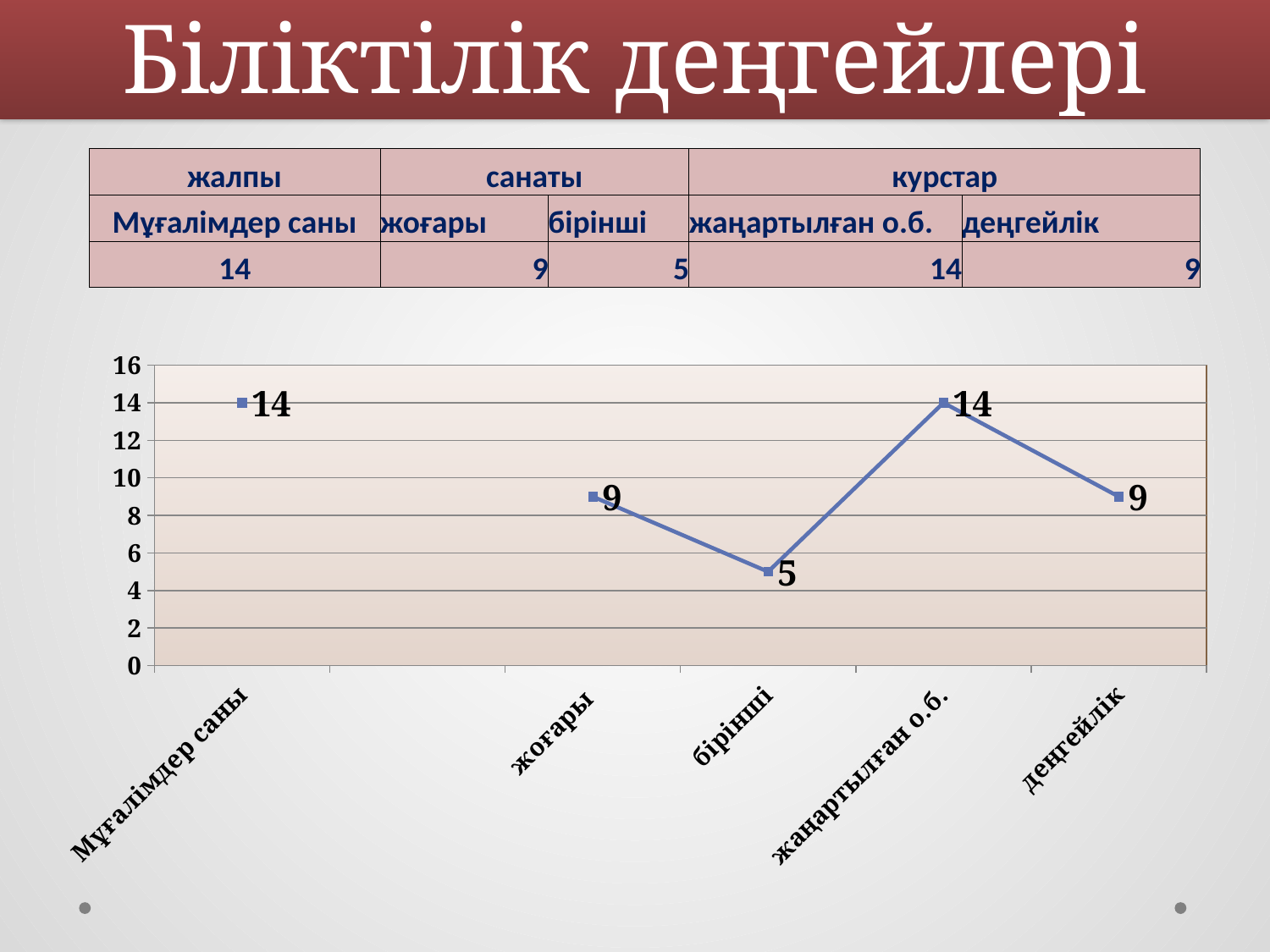
Does the line rise or fall from бірінші to жаңартылған о.б.? rise What is the value for деңгейлік? 9 Which category has the lowest value? бірінші What is the value for жоғары? 9 What is the difference between the values for жаңартылған о.б. and бірінші? 9 What type of chart is shown on the slide? line chart How many categories are shown on the x axis? 5 What is the value for жаңартылған о.б.? 14 What is the value for бірінші? 5 What is the difference between the values for жоғары and бірінші? 4 Which is larger, the value for жоғары or the value for бірінші? жоғары What is the value for Мұғалімдер саны? 14